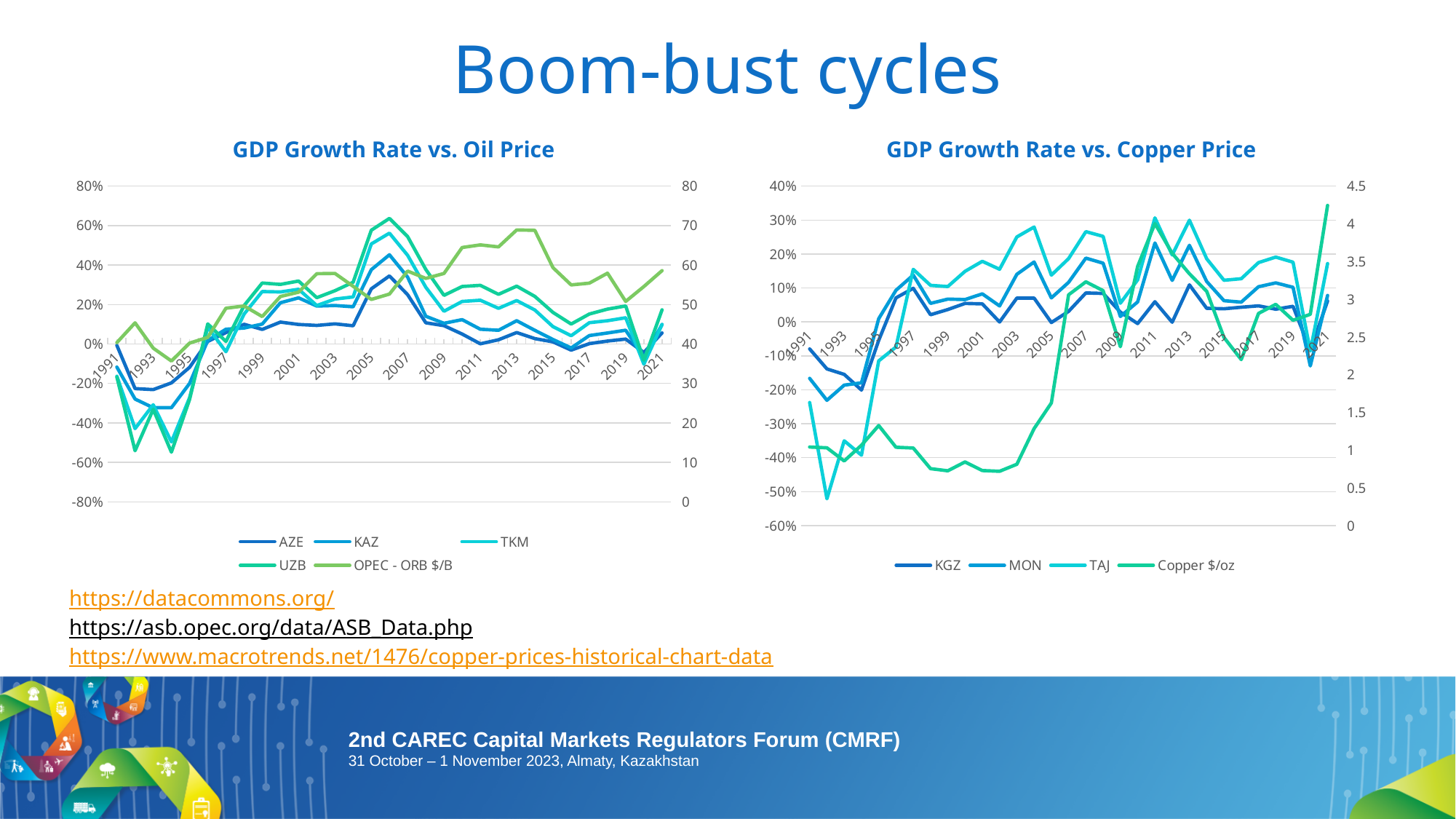
How many series does the legend of the 'GDP Growth Rate vs. Copper Price' chart list? 4 In the 'GDP Growth Rate vs. Oil Price' chart, is the value for AZE in 2007 greater or less than 20%? greater How many series does the legend of the 'GDP Growth Rate vs. Oil Price' chart list? 5 In the 'GDP Growth Rate vs. Copper Price' chart, which series is plotted in the legend besides KGZ, MON and TAJ? Copper $/oz How many year labels are shown on the x axis of the 'GDP Growth Rate vs. Oil Price' chart? 16 In the 'GDP Growth Rate vs. Oil Price' chart, which legend entry represents the oil price? OPEC - ORB $/B In the 'GDP Growth Rate vs. Copper Price' chart, does the Copper $/oz line rise or fall between 2003 and 2007? rise In the 'GDP Growth Rate vs. Copper Price' chart, is the value for MON in 2011 greater or less than 0%? greater In the 'GDP Growth Rate vs. Oil Price' chart, does the AZE line generally rise or fall between 2007 and 2017? fall What kind of chart is the 'GDP Growth Rate vs. Oil Price' chart? line chart